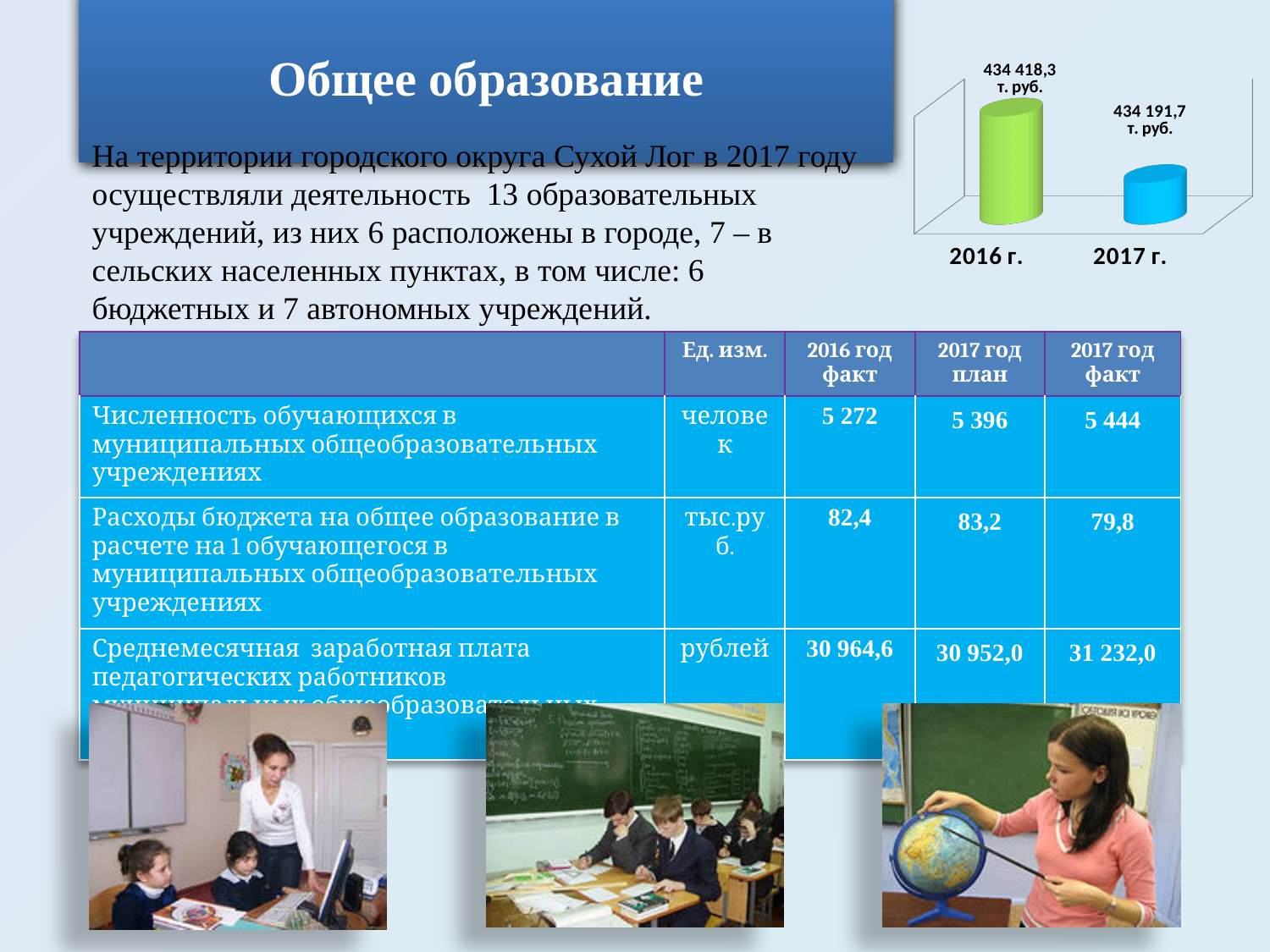
What kind of chart is shown in the top right of the slide? bar chart What colour is the bar for 2016 г. in the chart? green Which year has the lower value in the bar chart? 2017 г. Is the value for 2016 г. larger or smaller than the value for 2017 г. in the bar chart? larger What value is shown for 2017 г. in the bar chart? 434 191,7 т. руб. How many categories (years) are shown in the bar chart? 2 Do the values in the bar chart rise or fall from 2016 г. to 2017 г.? fall What colour is the bar for 2017 г. in the chart? blue Which year has the higher value in the bar chart? 2016 г. What value is shown for 2016 г. in the bar chart? 434 418,3 т. руб. By how much does the 2016 г. value exceed the 2017 г. value in the bar chart? 226,6 т. руб.